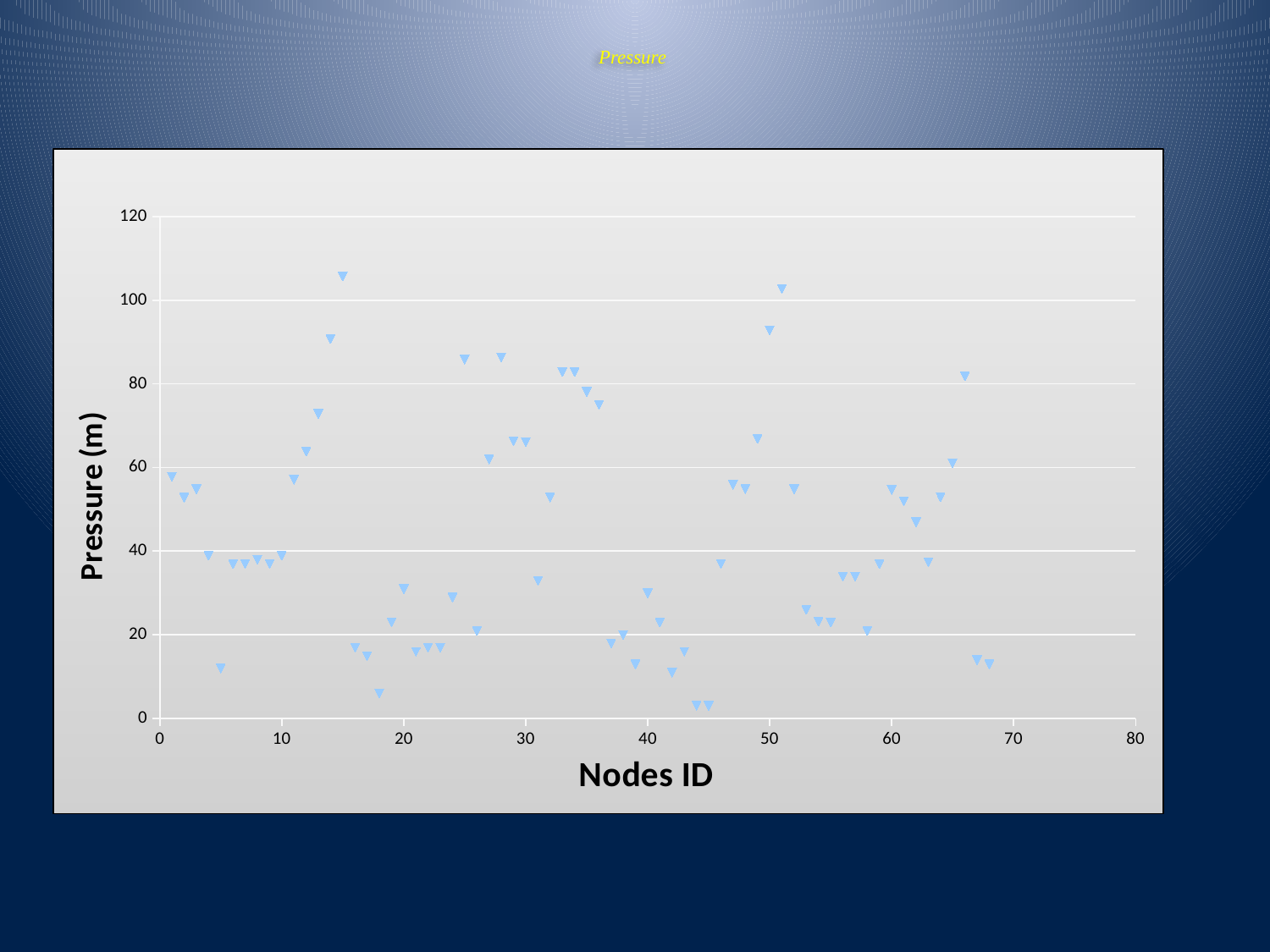
Is the pressure value for node ID 18 greater or less than 20? less Which has the higher pressure value, node ID 15 or node ID 5? node ID 15 What kind of chart is shown on the slide? scatter chart What is the title of the y axis of the chart? Pressure (m) What is the title of the x axis of the chart? Nodes ID Which has the lower pressure value, node ID 18 or node ID 25? node ID 18 Is the pressure value for node ID 5 greater or less than 20? less Is the pressure value for node ID 15 greater or less than 100? greater